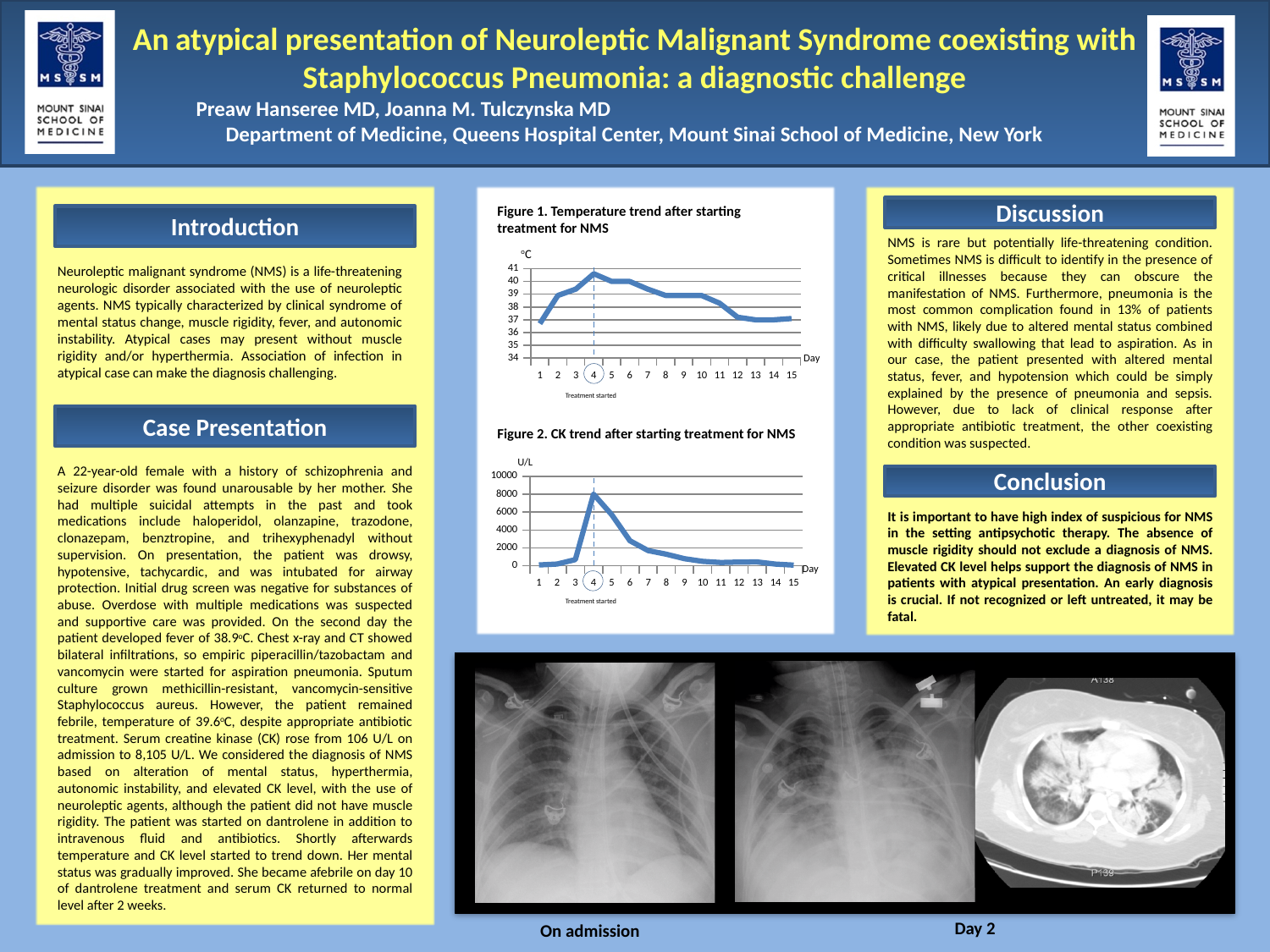
In Figure 1, is the temperature on day 4 greater or less than 40? greater In Figure 1, how many days are shown on the x axis? 15 In Figure 2, is the CK value on day 1 greater or less than 2000? less In Figure 2, is the CK value on day 4 greater or less than 6000? greater In Figure 2, do the CK values rise or fall from day 4 to day 15? fall In Figure 2, how many days are shown on the x axis? 15 What kind of chart is Figure 1 (Temperature trend after starting treatment for NMS)? line chart In Figure 1, on which day is the temperature highest? Day 4 In Figure 1, what unit is shown on the y axis? °C What kind of chart is Figure 2 (CK trend after starting treatment for NMS)? line chart In Figure 2, on which day is the CK level highest? Day 4